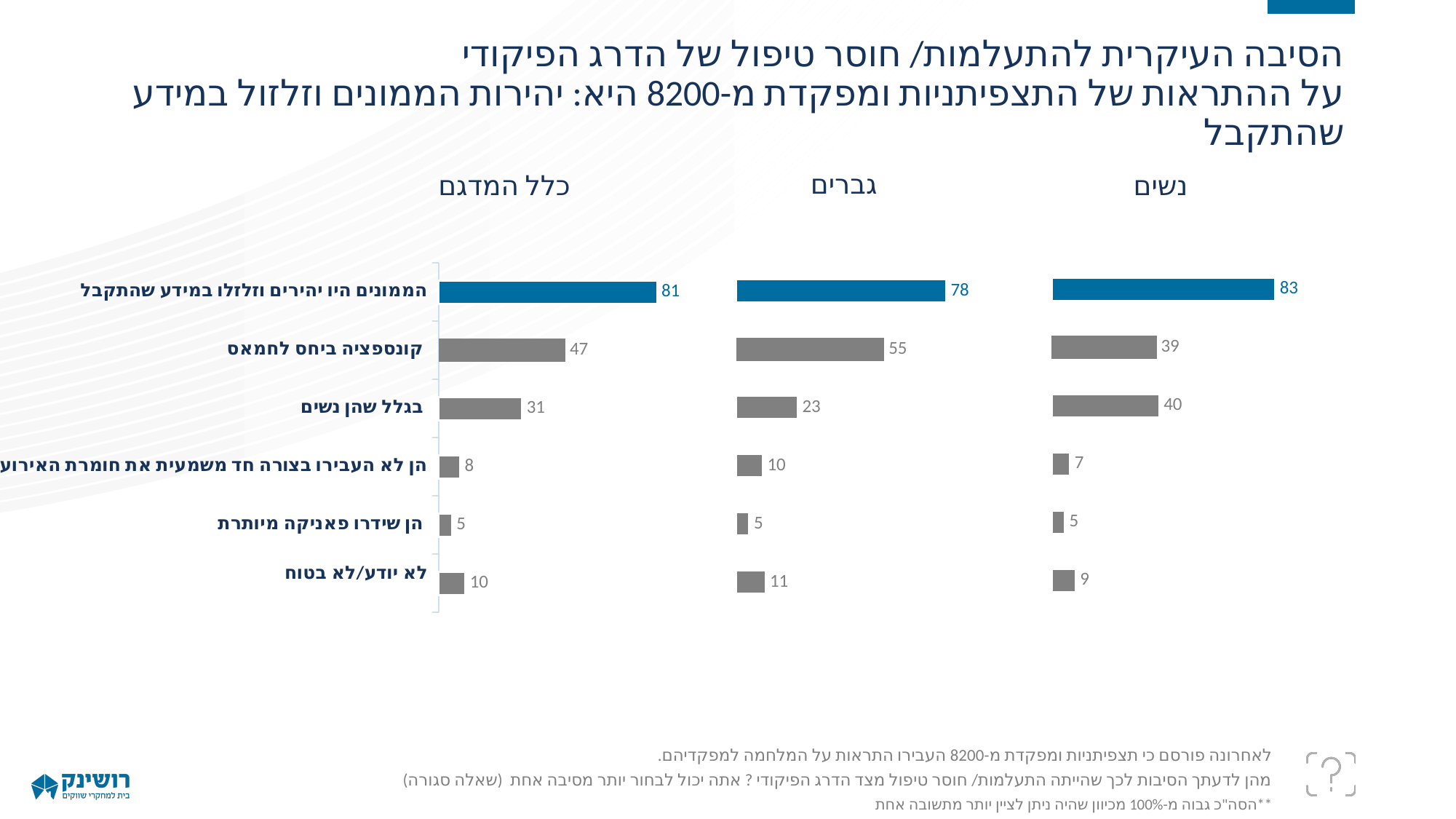
In the "גברים" chart, which category has the lowest value? הן שידרו פאניקה מיותרת In the "נשים" chart, what is the value for "בגלל שהן נשים"? 40 In the "כלל המדגם" chart, what is the value for "לא יודע/לא בטוח"? 10 What is the difference between the "גברים" and "נשים" values for "קונספציה ביחס לחמאס"? 16 What type of chart is used on this slide? Bar chart Which bar in each chart is coloured blue rather than grey? הממונים היו יהירים וזלזלו במידע שהתקבל In the "כלל המדגם" chart, what is the value for "הממונים היו יהירים וזלזלו במידע שהתקבל"? 81 What is the difference between the "נשים" and "גברים" values for "הממונים היו יהירים וזלזלו במידע שהתקבל"? 5 How many categories are shown in the "כלל המדגם" chart? 6 In the "נשים" chart, which category has the highest value? הממונים היו יהירים וזלזלו במידע שהתקבל For "בגלל שהן נשים", which is larger: the "גברים" value or the "נשים" value? נשים In the "גברים" chart, what is the value for "קונספציה ביחס לחמאס"? 55